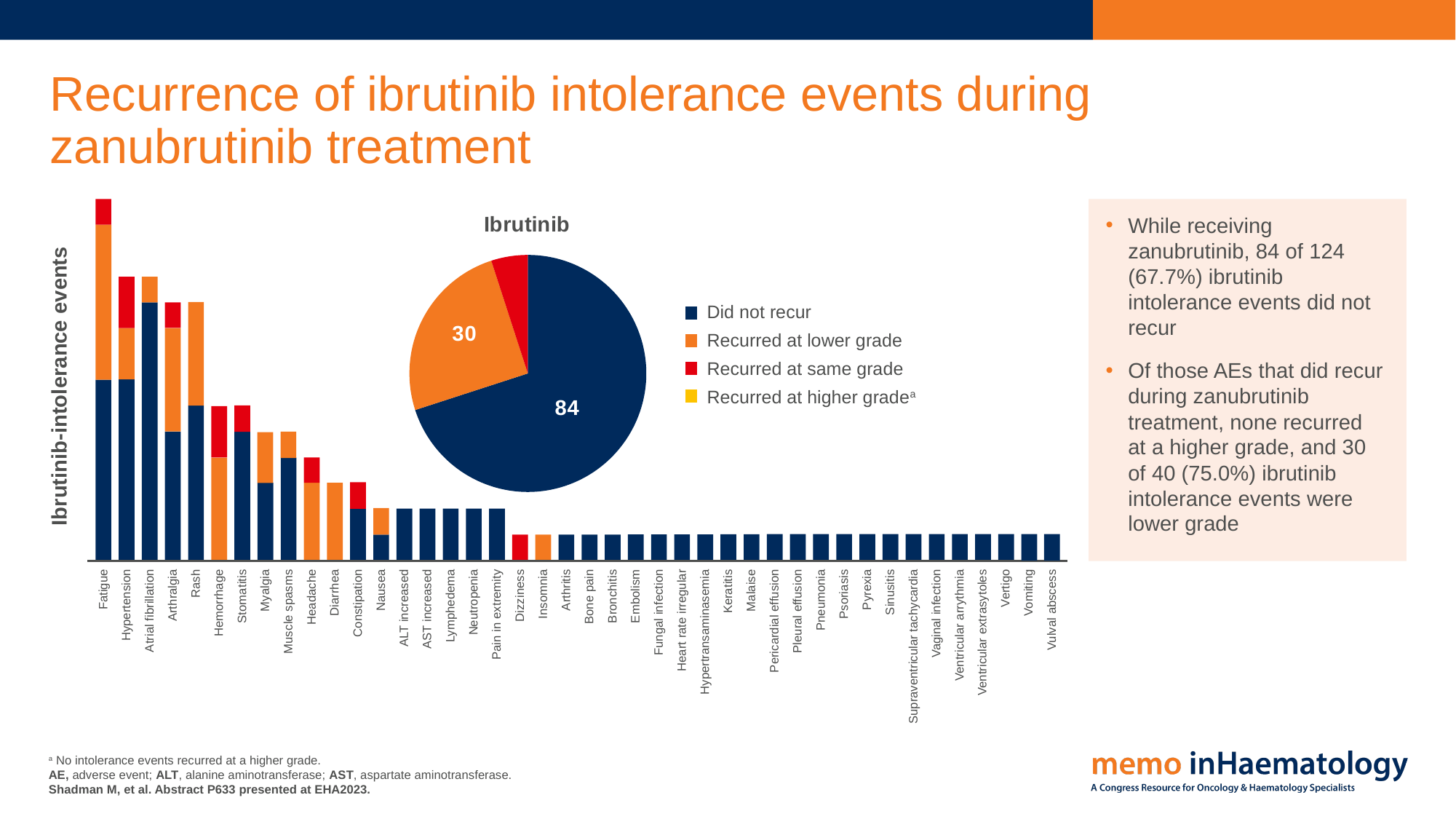
How many series does the legend of the pie chart titled "Ibrutinib" list? 4 What is the y-axis label of the bar chart on the left? Ibrutinib-intolerance events In the bar chart on the left, do the bar heights generally rise or fall from left to right along the x axis? Fall In the pie chart titled "Ibrutinib", what is the value for "Recurred at lower grade"? 30 What kind of chart is the chart on the left of the slide? Bar chart How many categories are shown on the x axis of the bar chart on the left? 42 In the pie chart titled "Ibrutinib", which category has the largest slice? Did not recur In the pie chart titled "Ibrutinib", what is the difference between the "Did not recur" value and the "Recurred at lower grade" value? 54 In the bar chart on the left, which bar is taller: Fatigue or Hypertension? Fatigue In the pie chart titled "Ibrutinib", what is the value for "Did not recur"? 84 What kind of chart is the chart titled "Ibrutinib"? Pie chart In the bar chart on the left, which category has the tallest bar? Fatigue